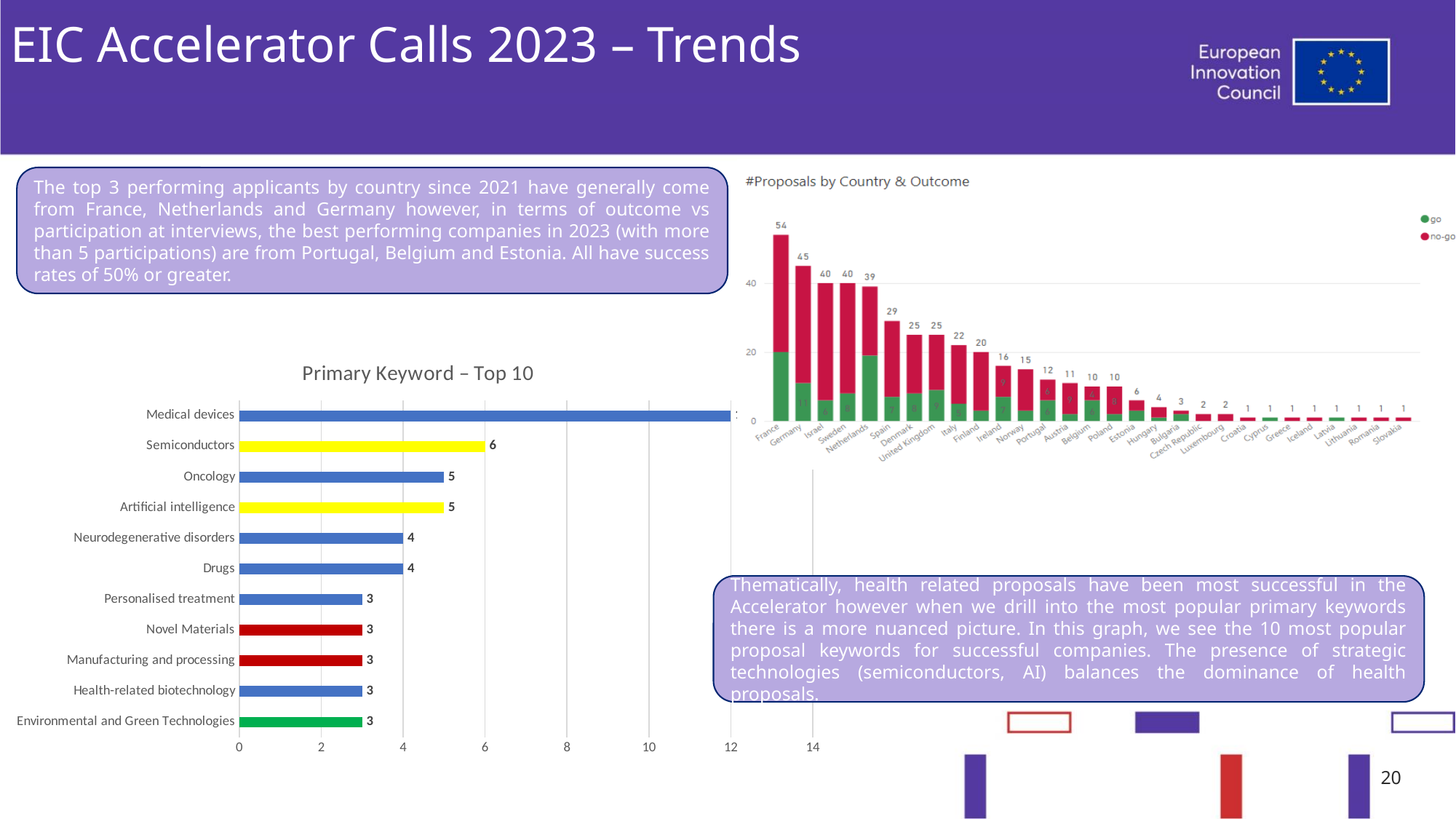
In the #Proposals by Country & Outcome chart, what is the total number of proposals for France? 54 In the #Proposals by Country & Outcome chart, what is the difference between the totals for Germany and Netherlands? 6 How many bars are plotted in the Primary Keyword – Top 10 chart? 11 In the Primary Keyword – Top 10 chart, is the value for Medical devices greater or less than 10? greater In the Primary Keyword – Top 10 chart, what is the value for Neurodegenerative disorders? 4 How many series does the legend of the #Proposals by Country & Outcome chart list? 2 In the Primary Keyword – Top 10 chart, what is the difference between the values for Semiconductors and Oncology? 1 In the Primary Keyword – Top 10 chart, which keyword has the highest value? Medical devices In the Primary Keyword – Top 10 chart, what is the value for Semiconductors? 6 What kind of chart is the Primary Keyword – Top 10 chart? bar chart In the Primary Keyword – Top 10 chart, which is larger, the value for Drugs or the value for Novel Materials? Drugs In the #Proposals by Country & Outcome chart, what is the total number of proposals for Spain? 29